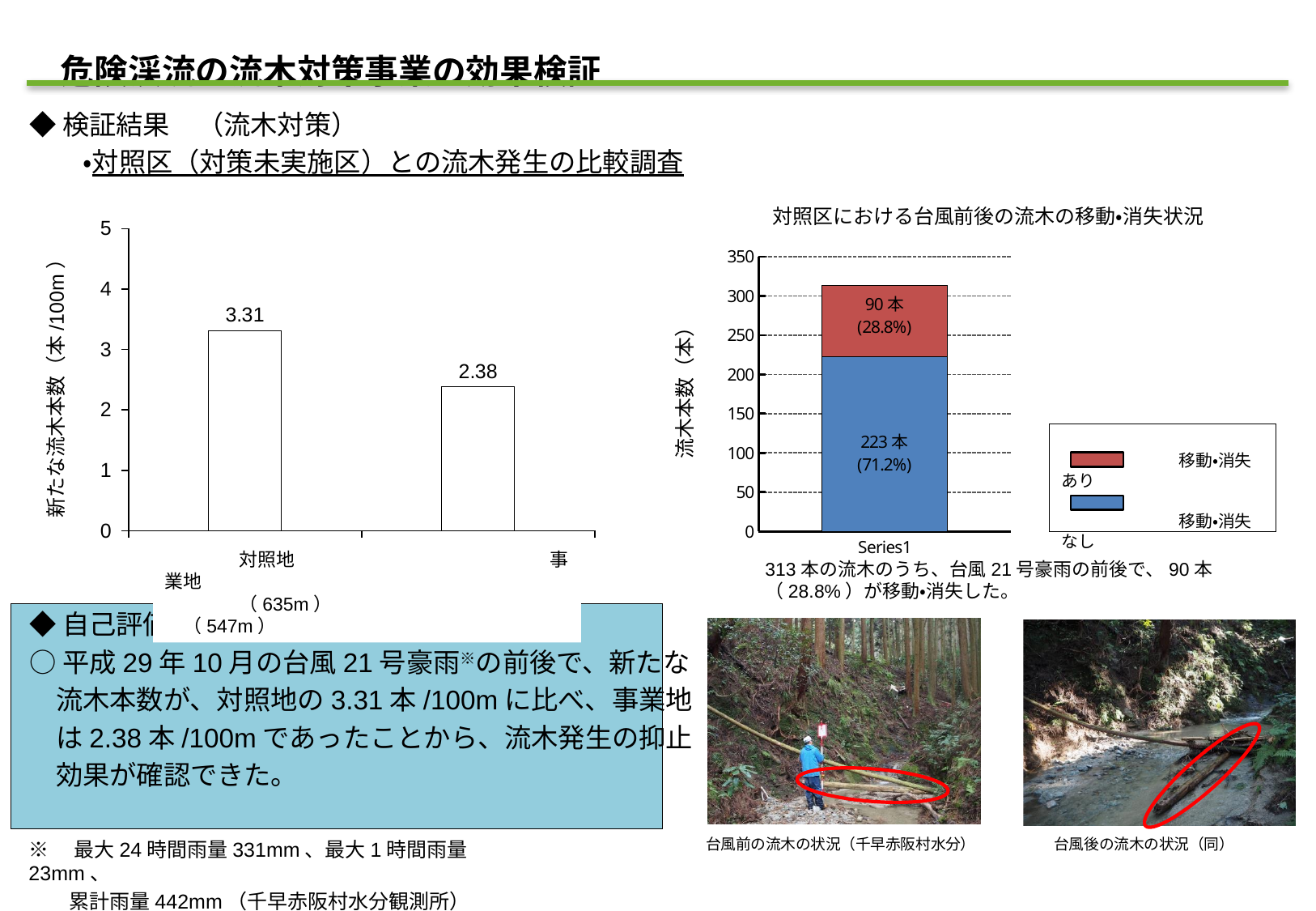
What kind of chart is the left chart? bar chart In the chart titled 対照区における台風前後の流木の移動•消失状況, how many 本 are in the 移動•消失あり segment? 90本 In the left bar chart, which category has the higher value, 対照地 or 事業地? 対照地 In the left bar chart, what is the difference between the values for 対照地 and 事業地? 0.93 In the chart titled 対照区における台風前後の流木の移動•消失状況, what colour is the 移動•消失あり segment? red In the chart titled 対照区における台風前後の流木の移動•消失状況, how many 本 are in the 移動•消失なし segment? 223本 In the chart titled 対照区における台風前後の流木の移動•消失状況, what is the total of the stacked bar? 313本 In the left bar chart, what is the value for 対照地? 3.31 In the left bar chart, how many bars are plotted? 2 In the left bar chart, what is the value for 事業地? 2.38 In the chart titled 対照区における台風前後の流木の移動•消失状況, how many series does the legend list? 2 In the left bar chart, is the value for 事業地 greater or less than 3? less